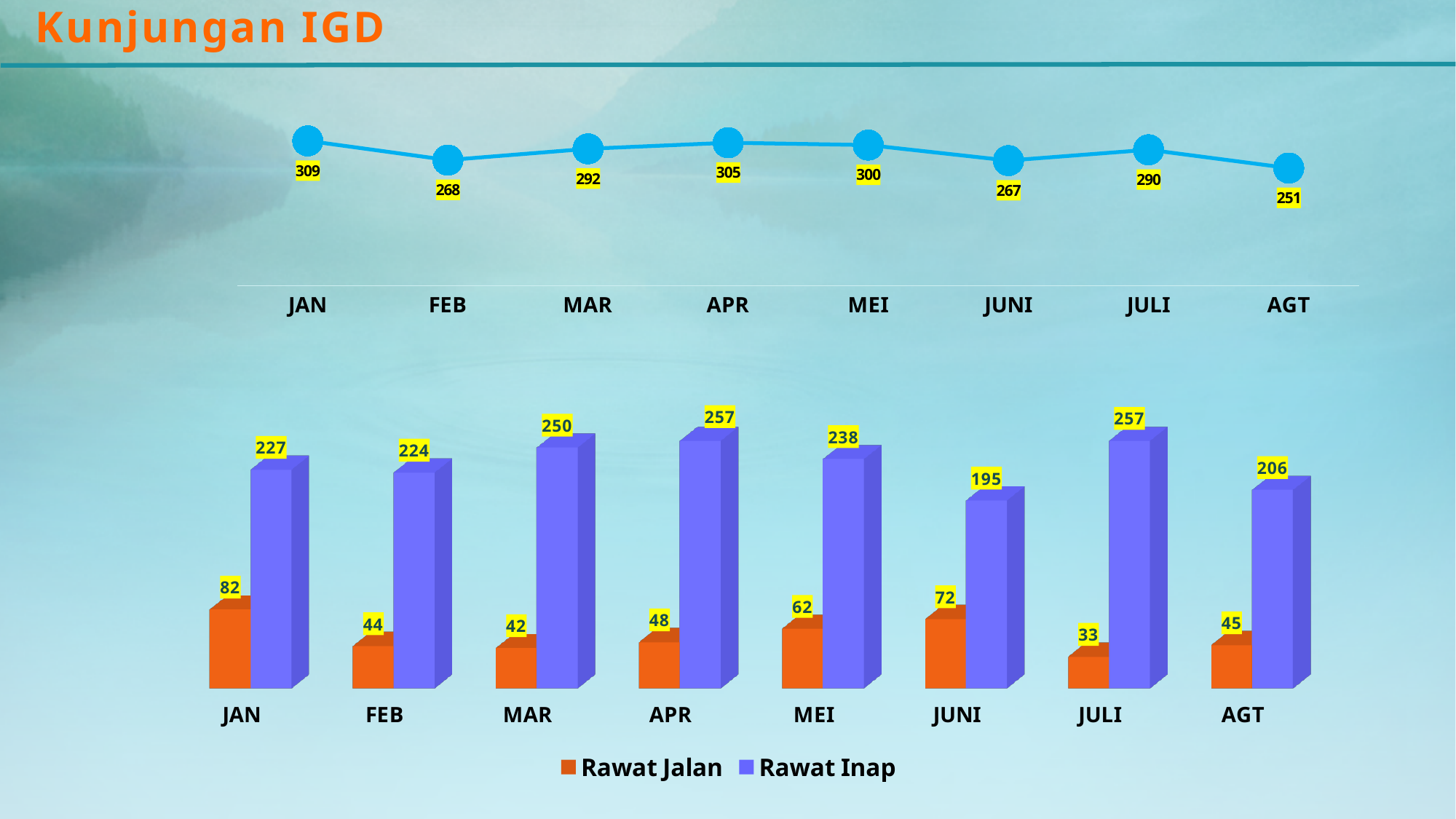
In the bar chart at the bottom of the slide, what is the Rawat Jalan value for MEI? 62 In the bar chart at the bottom of the slide, which month has the lowest Rawat Inap value? JUNI In the line chart at the top of the slide, what is the value for JAN? 309 In the line chart at the top of the slide, how many data points are plotted? 8 In the bar chart at the bottom of the slide, what is the Rawat Inap value for MAR? 250 In the line chart at the top of the slide, which month has the lowest value? AGT In the bar chart at the bottom of the slide, which is larger: the Rawat Inap value for FEB or for AGT? FEB In the bar chart at the bottom of the slide, which month has the highest Rawat Jalan value? JAN In the line chart at the top of the slide, what is the difference between the values for APR and JUNI? 38 In the bar chart at the bottom of the slide, what is the difference between the Rawat Jalan values for JUNI and JULI? 39 In the line chart at the top of the slide, which month has the highest value? JAN How many series does the legend of the bar chart at the bottom of the slide list? 2